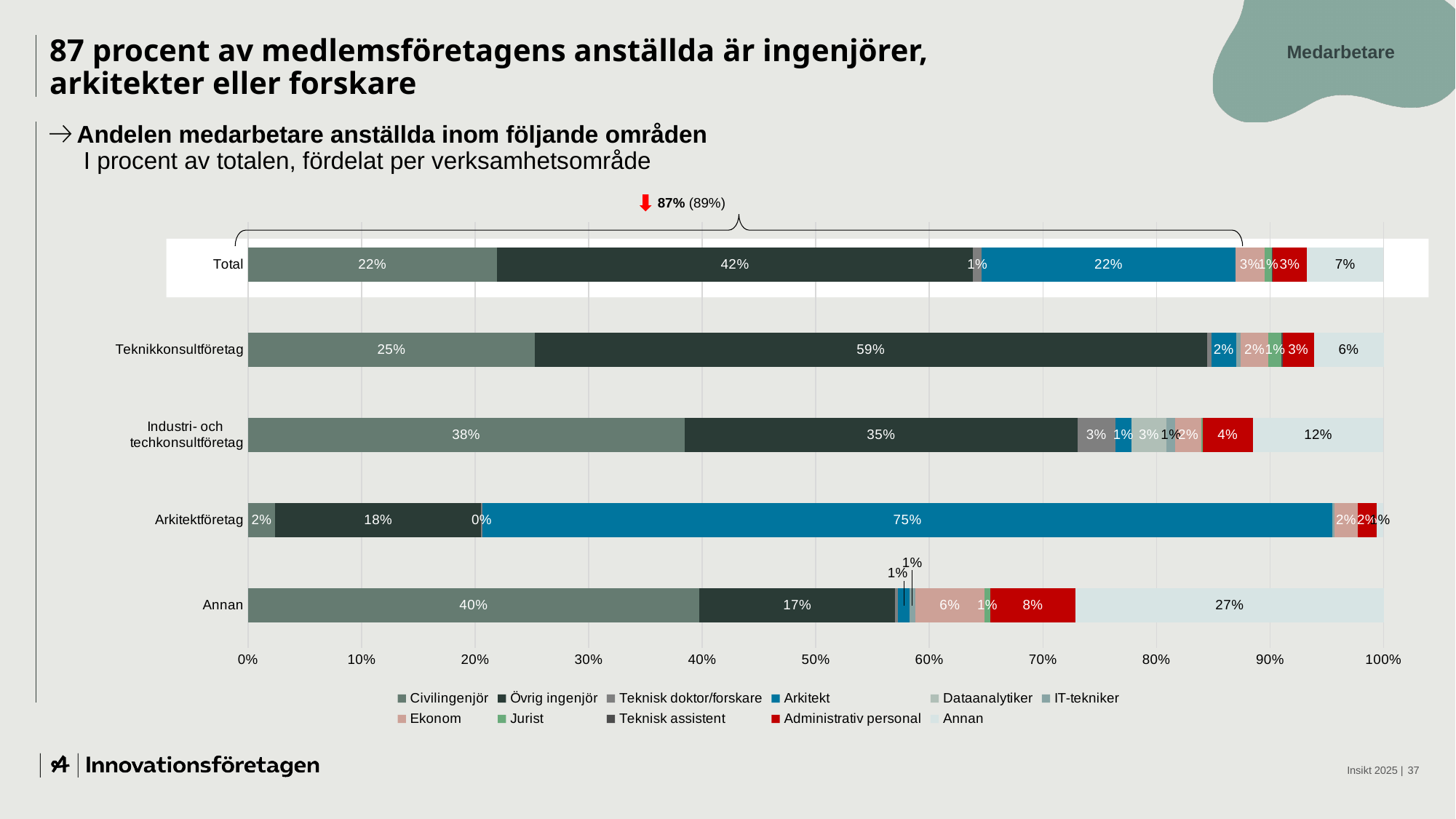
What is the share of Administrativ personal for Industri- och techkonsultföretag? 4% What is the share of Arkitekt for Arkitektföretag? 75% Which category has the lowest share of Civilingenjör? Arkitektföretag What kind of chart is shown on the slide? Stacked bar chart Which is larger for Total: the share of Civilingenjör or the share of Övrig ingenjör? Övrig ingenjör How many series does the legend list? 11 How many categories (bars) are plotted on the chart? 5 What is the share of Övrig ingenjör for Teknikkonsultföretag? 59% What is the difference between the Övrig ingenjör share for Teknikkonsultföretag and for Total? 17 percentage points Which category has the highest share of Civilingenjör? Annan What is the share of Annan (the series) for the Annan category? 27% What is the share of Civilingenjör for Industri- och techkonsultföretag? 38%